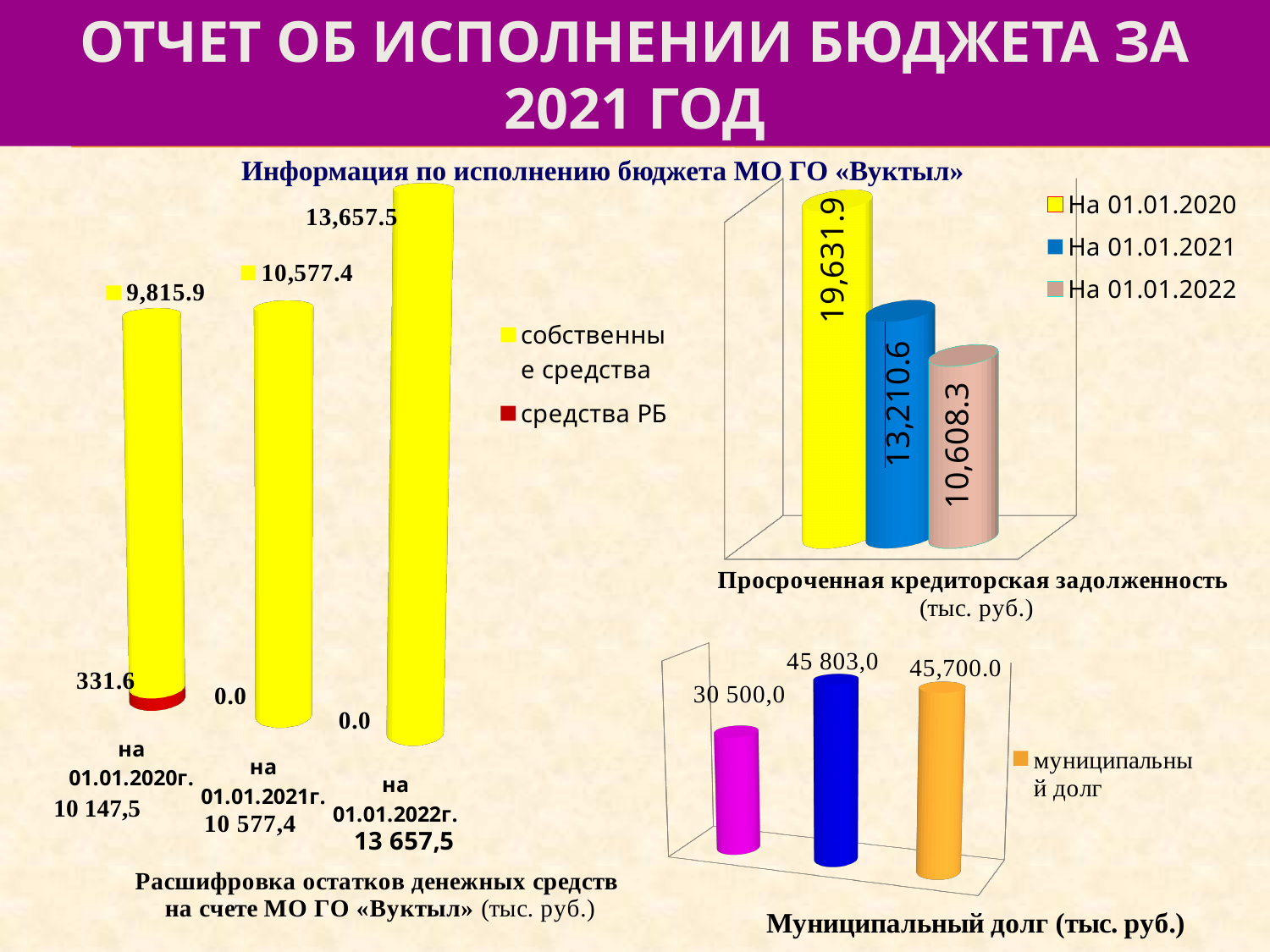
In the chart 'Расшифровка остатков денежных средств на счете МО ГО «Вуктыл»', what is the value of средства РБ на 01.01.2020г.? 331.6 In the chart 'Расшифровка остатков денежных средств на счете МО ГО «Вуктыл»', what is the total for на 01.01.2020г.? 10 147,5 In the chart 'Просроченная кредиторская задолженность (тыс. руб.)', how many entries does the legend list? 3 In the chart 'Расшифровка остатков денежных средств на счете МО ГО «Вуктыл»', how many series does the legend list? 2 In the chart 'Муниципальный долг (тыс. руб.)', how many bars are plotted? 3 In the chart 'Просроченная кредиторская задолженность (тыс. руб.)', do the values rise or fall from 01.01.2020 to 01.01.2022? fall In the chart 'Просроченная кредиторская задолженность (тыс. руб.)', what is the value for На 01.01.2020? 19,631.9 In the chart 'Расшифровка остатков денежных средств на счете МО ГО «Вуктыл»', which date has the highest value of собственные средства? на 01.01.2022г. In the chart 'Просроченная кредиторская задолженность (тыс. руб.)', what is the value for На 01.01.2022? 10,608.3 In the chart 'Просроченная кредиторская задолженность (тыс. руб.)', which date has the lowest value? На 01.01.2022 In the chart 'Муниципальный долг (тыс. руб.)', what is the value of the leftmost bar? 30 500,0 In the chart 'Расшифровка остатков денежных средств на счете МО ГО «Вуктыл»', what is the value of собственные средства на 01.01.2021г.? 10,577.4